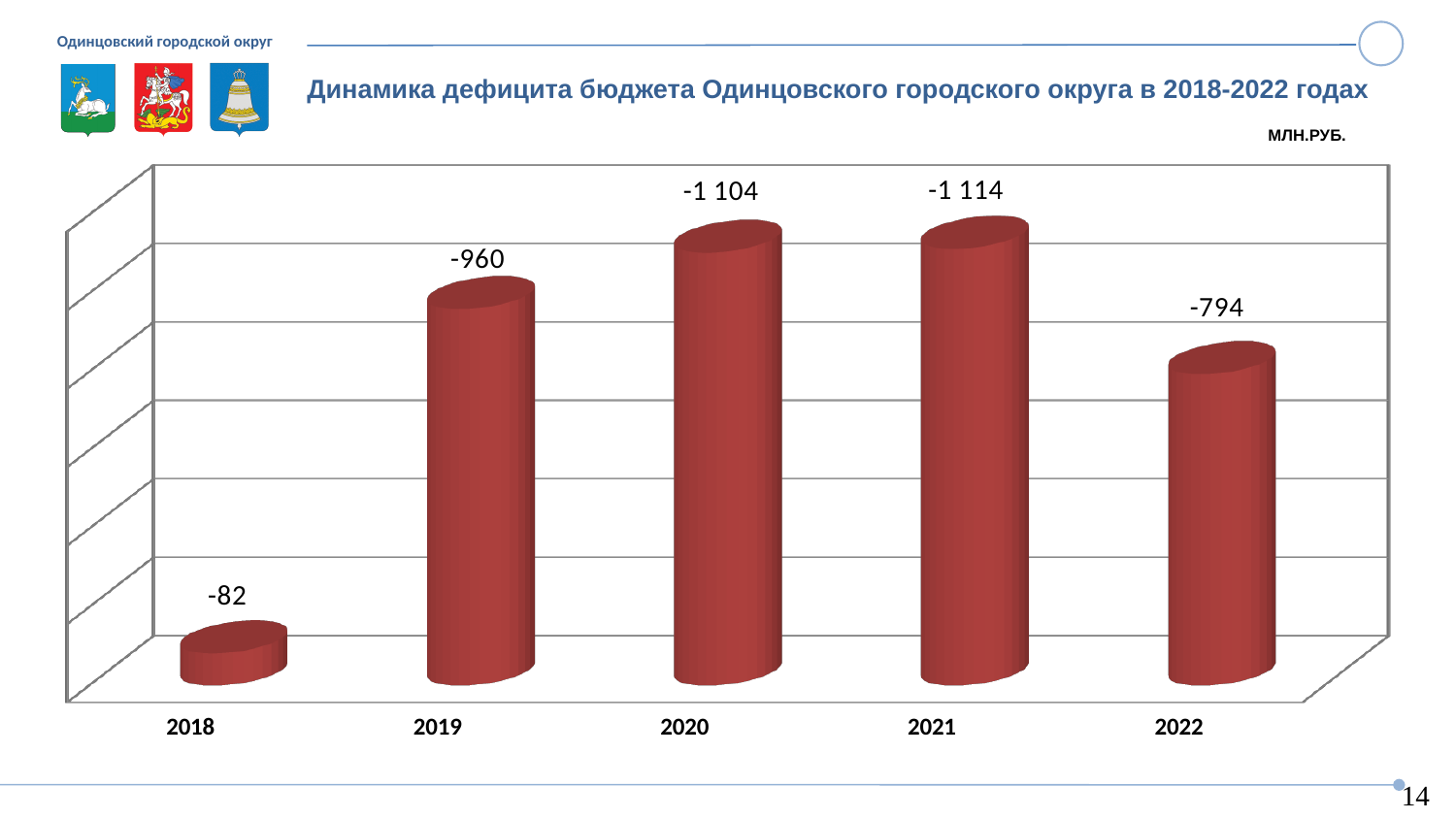
Which year has the smallest budget deficit (the shortest bar)? 2018 What is the budget deficit value shown for 2022? -794 What is the budget deficit value shown for 2018? -82 In what units are the values on the chart expressed? МЛН.РУБ. What is the budget deficit value shown for 2020? -1 104 What is the budget deficit value shown for 2019? -960 Which year has the larger deficit magnitude, 2019 or 2022? 2019 What is the difference in deficit magnitude between 2019 and 2018? 878 Which year has the largest budget deficit (the tallest bar)? 2021 How many years are shown on the chart? 5 By how much does the deficit magnitude for 2021 exceed that for 2020? 10 What type of chart is shown on the slide? Bar chart